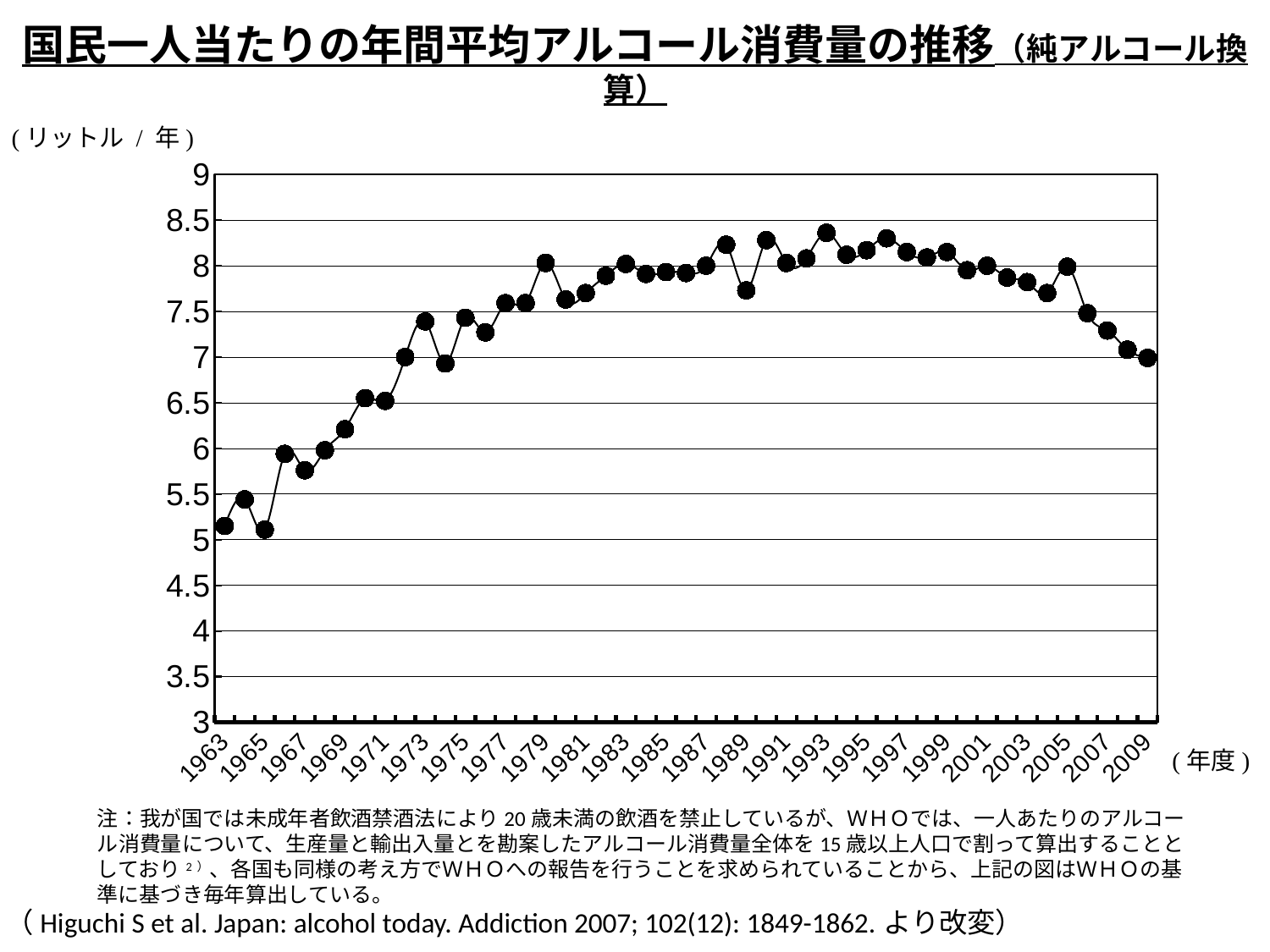
Do the values rise or fall from 2005 to 2009? fall Which is larger, the value for 1963 or the value for 2009? 2009 Is the value for 1973 greater or less than 7? greater Which is larger, the value for 1969 or the value for 1983? 1983 Do the values rise or fall from 1963 to 1973? rise Is the value for 1969 greater or less than 6? greater Is the value for 1993 greater or less than 8? greater What kind of chart is shown on the slide? line chart What unit is shown for the vertical axis? リットル / 年